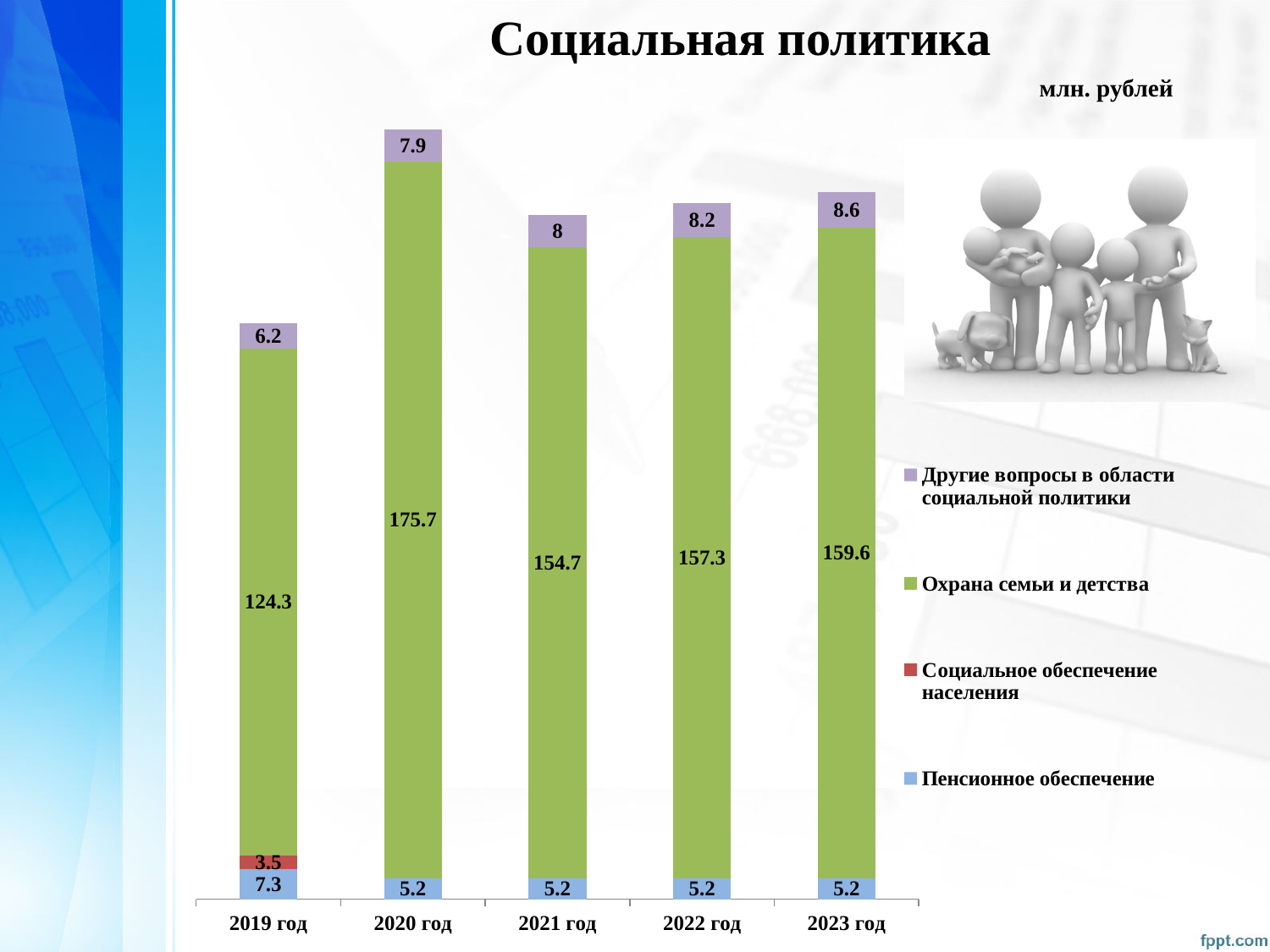
What is the value for Другие вопросы в области социальной политики in 2023 год? 8.6 In which year is the value for Охрана семьи и детства the highest? 2020 год What is the total of the stacked bar for 2019 год? 141.3 What is the value for Охрана семьи и детства in 2020 год? 175.7 What unit is stated for the values on the chart? млн. рублей How many years are shown on the x axis? 5 What type of chart is shown on the slide? Stacked bar chart What is the value for Социальное обеспечение населения in 2019 год? 3.5 How many series does the legend list? 4 Which is larger: the Другие вопросы в области социальной политики value for 2020 год or for 2021 год? 2021 год In which year is the value for Пенсионное обеспечение the highest? 2019 год What is the difference between the Охрана семьи и детства values for 2023 год and 2022 год? 2.3